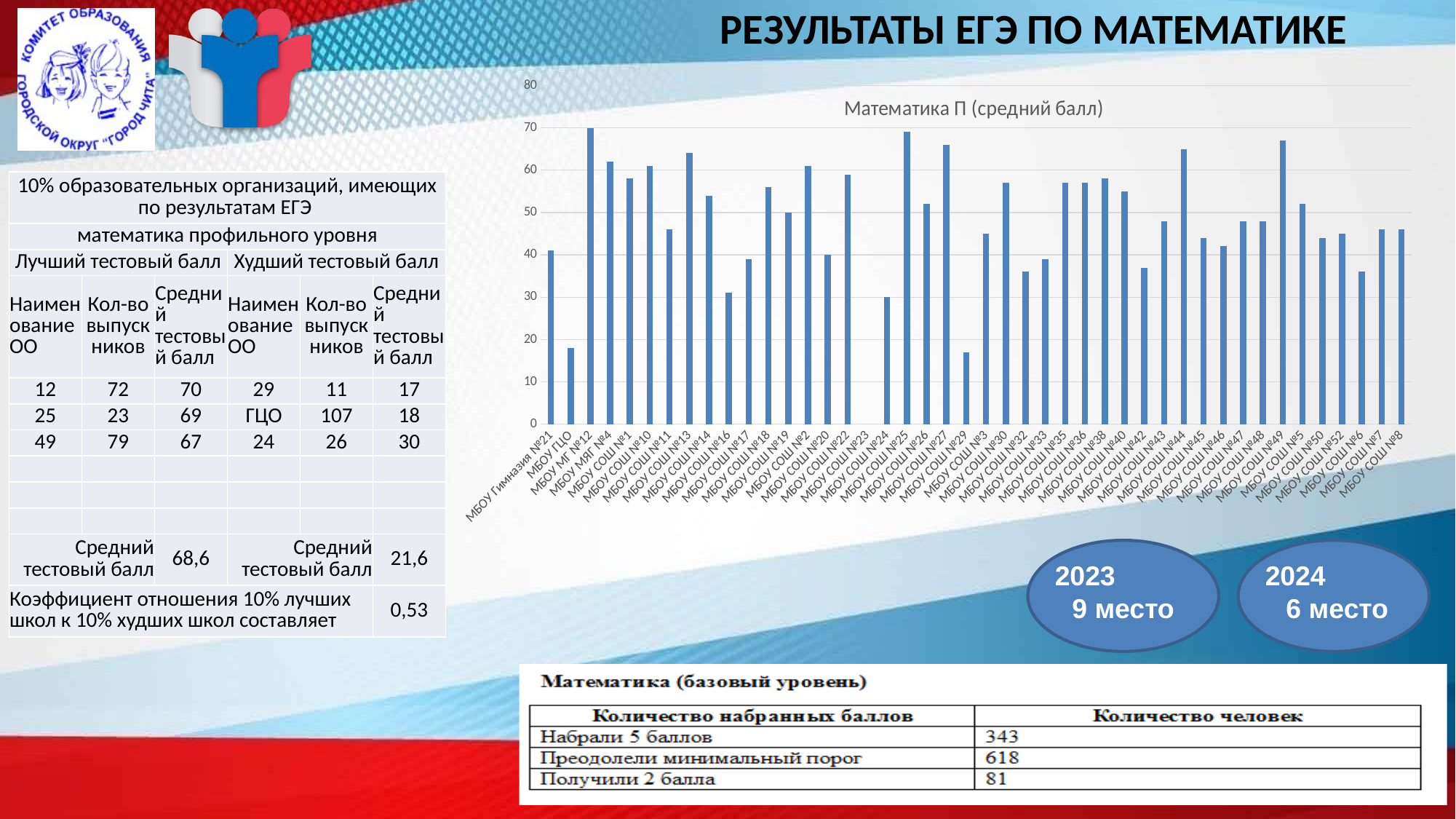
Which has the larger value, МБОУ МГ №12 or МБОУ ГЦО? МБОУ МГ №12 Is the value for МБОУ МГ №12 greater or less than 60? greater Is the value for МБОУ ГЦО greater or less than 20? less What kind of chart is shown on the slide? bar chart Which has the larger value, МБОУ СОШ №44 or МБОУ СОШ №45? МБОУ СОШ №44 Is the value for МБОУ СОШ №24 greater or less than 40? less Which has the larger value, МБОУ СОШ №25 or МБОУ СОШ №24? МБОУ СОШ №25 What is the title of the chart? Математика П (средний балл)